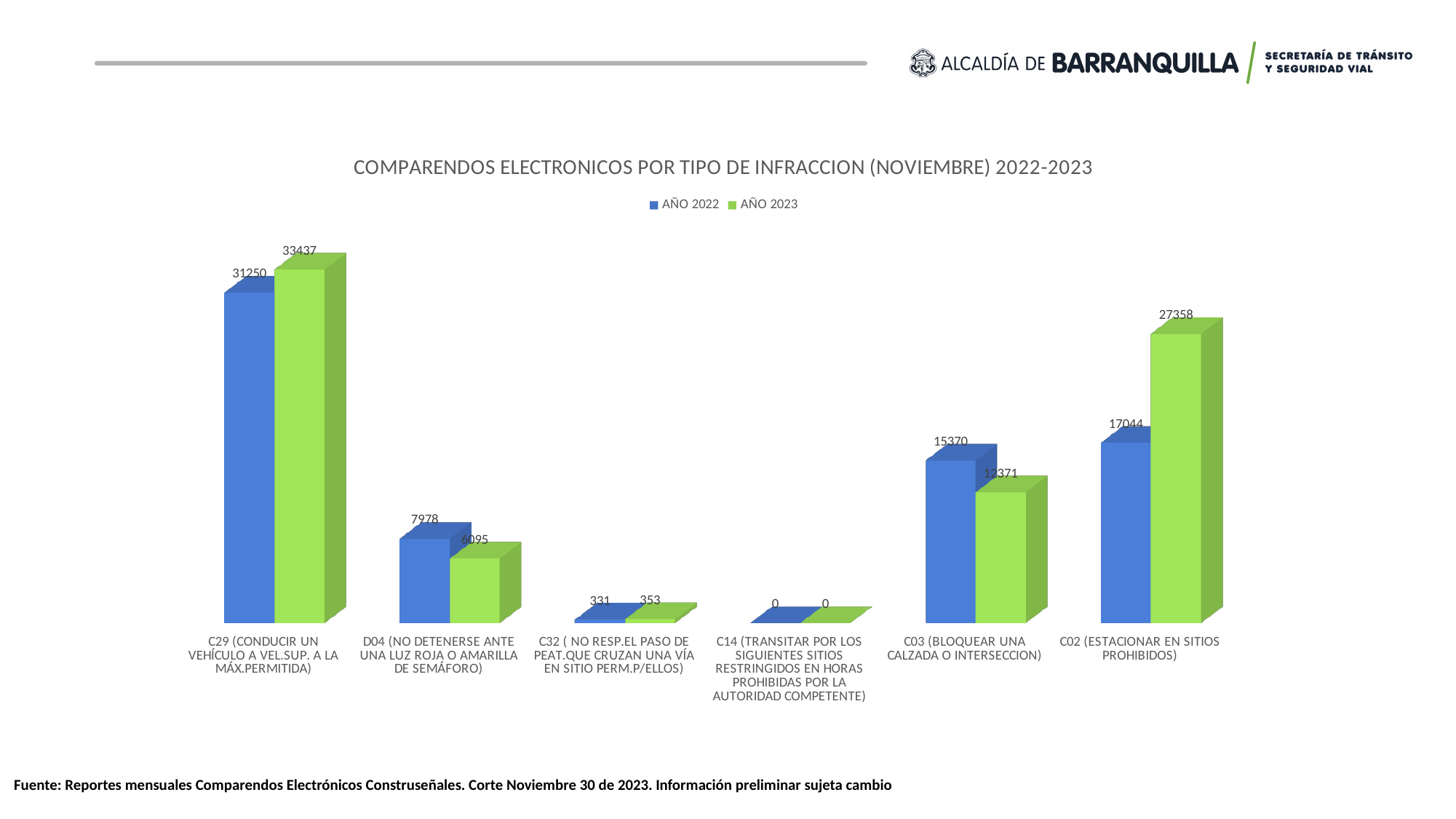
For C32 ( NO RESP.EL PASO DE PEAT.QUE CRUZAN UNA VÍA EN SITIO PERM.P/ELLOS), which year has the larger value, AÑO 2022 or AÑO 2023? AÑO 2023 Which category has the lowest value for AÑO 2022? C14 (TRANSITAR POR LOS SIGUIENTES SITIOS RESTRINGIDOS EN HORAS PROHIBIDAS POR LA AUTORIDAD COMPETENTE) What is the value for AÑO 2022 for D04 (NO DETENERSE ANTE UNA LUZ ROJA O AMARILLA DE SEMÁFORO)? 7978 What is the difference between AÑO 2022 and AÑO 2023 for C03 (BLOQUEAR UNA CALZADA O INTERSECCION)? 2999 How many series does the legend list? 2 What is the value for AÑO 2023 for C02 (ESTACIONAR EN SITIOS PROHIBIDOS)? 27358 What is the difference between AÑO 2023 and AÑO 2022 for C02 (ESTACIONAR EN SITIOS PROHIBIDOS)? 10314 What is the value for AÑO 2023 for C29 (CONDUCIR UN VEHÍCULO A VEL.SUP. A LA MÁX.PERMITIDA)? 33437 What kind of chart is shown on the slide? Bar chart What is the value for AÑO 2022 for C03 (BLOQUEAR UNA CALZADA O INTERSECCION)? 15370 How many infraction categories are shown on the chart? 6 Which category has the highest value for AÑO 2023? C29 (CONDUCIR UN VEHÍCULO A VEL.SUP. A LA MÁX.PERMITIDA)